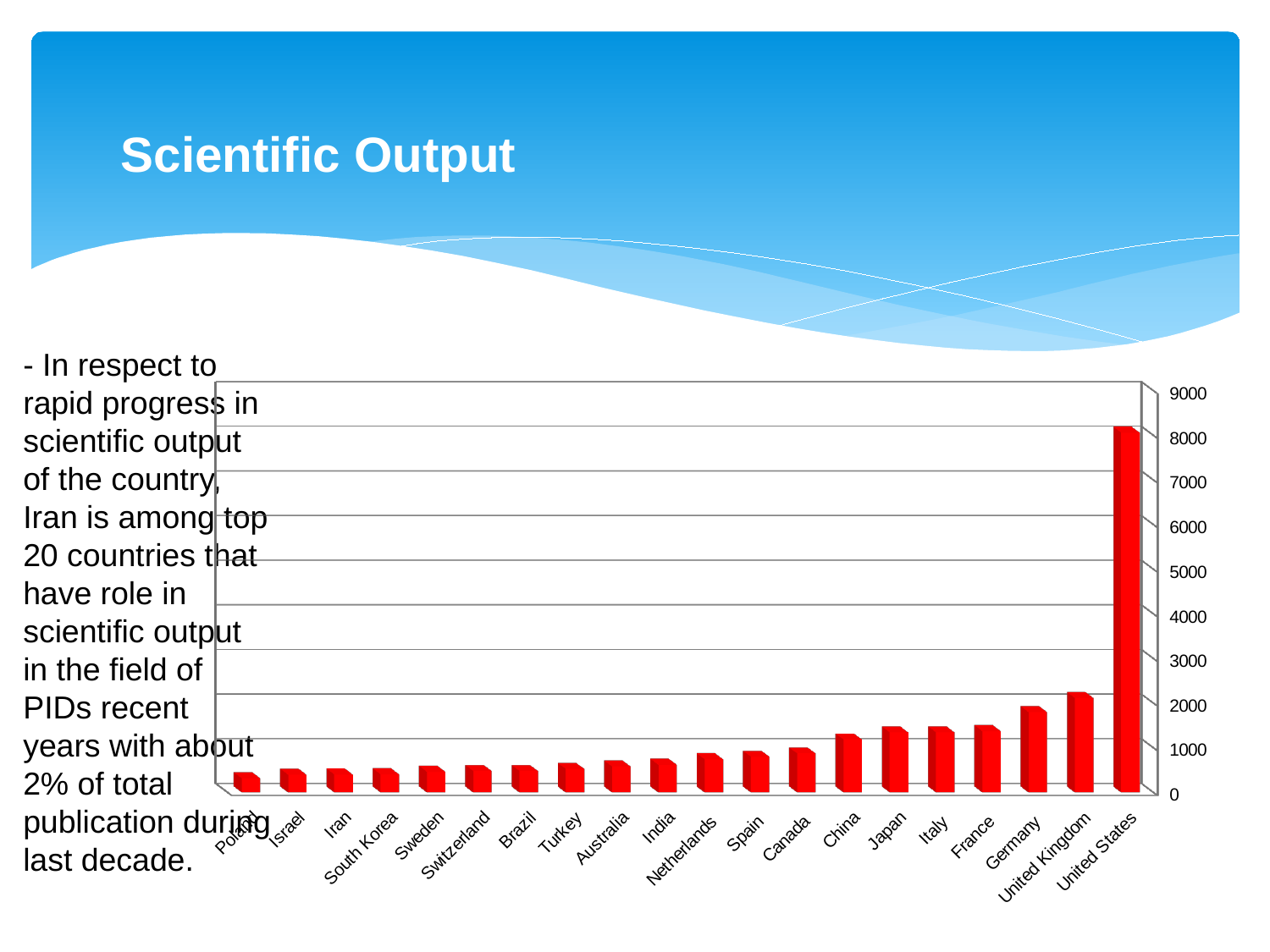
What kind of chart is shown on the slide? bar chart Do the values generally rise or fall moving from left to right along the x axis? rise Is the value for United States greater or less than 7000? greater How many countries are shown on the x axis of the chart? 20 Which country has the lowest value in the chart? Poland Which has a larger value, United Kingdom or Germany? United Kingdom Which country has the highest value in the chart? United States Is the value for Iran greater or less than 1000? less What colour are the bars in the chart? red Is the value for China greater or less than 1000? greater